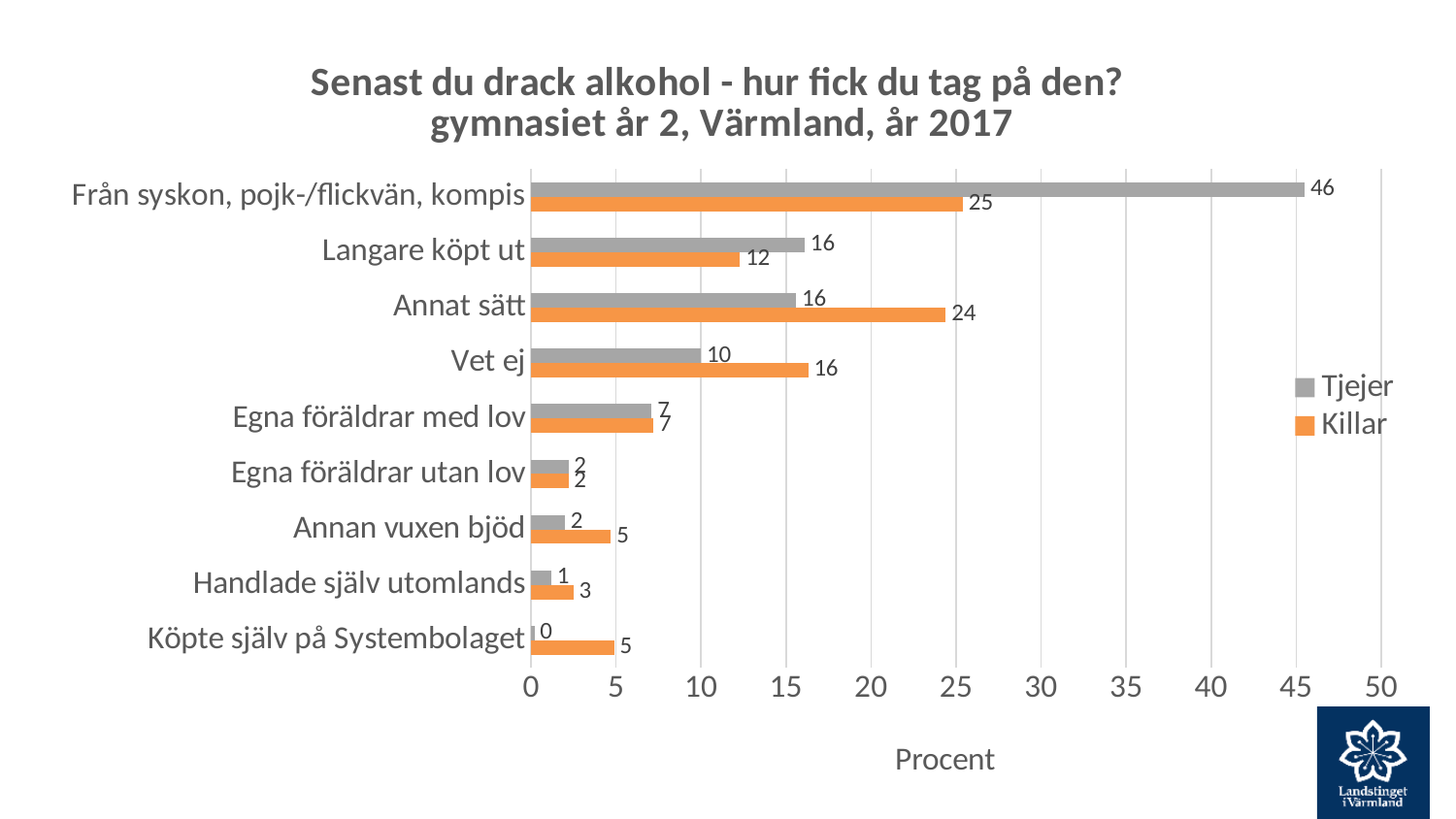
What is the difference between the Tjejer and Killar values for "Från syskon, pojk-/flickvän, kompis"? 21 How many series does the legend list? 2 Is the Tjejer value for "Från syskon, pojk-/flickvän, kompis" greater or less than 40? greater What is the value for Tjejer in the category "Från syskon, pojk-/flickvän, kompis"? 46 How many categories are shown on the chart? 9 What is the value for Killar in the category "Annat sätt"? 24 What is the value for Killar in the category "Köpte själv på Systembolaget"? 5 Which category has the highest value for Tjejer? Från syskon, pojk-/flickvän, kompis What is the label of the horizontal axis? Procent What kind of chart is shown on the slide? bar chart Which category has the lowest value for Tjejer? Köpte själv på Systembolaget Which is larger for "Vet ej": the Tjejer value or the Killar value? Killar